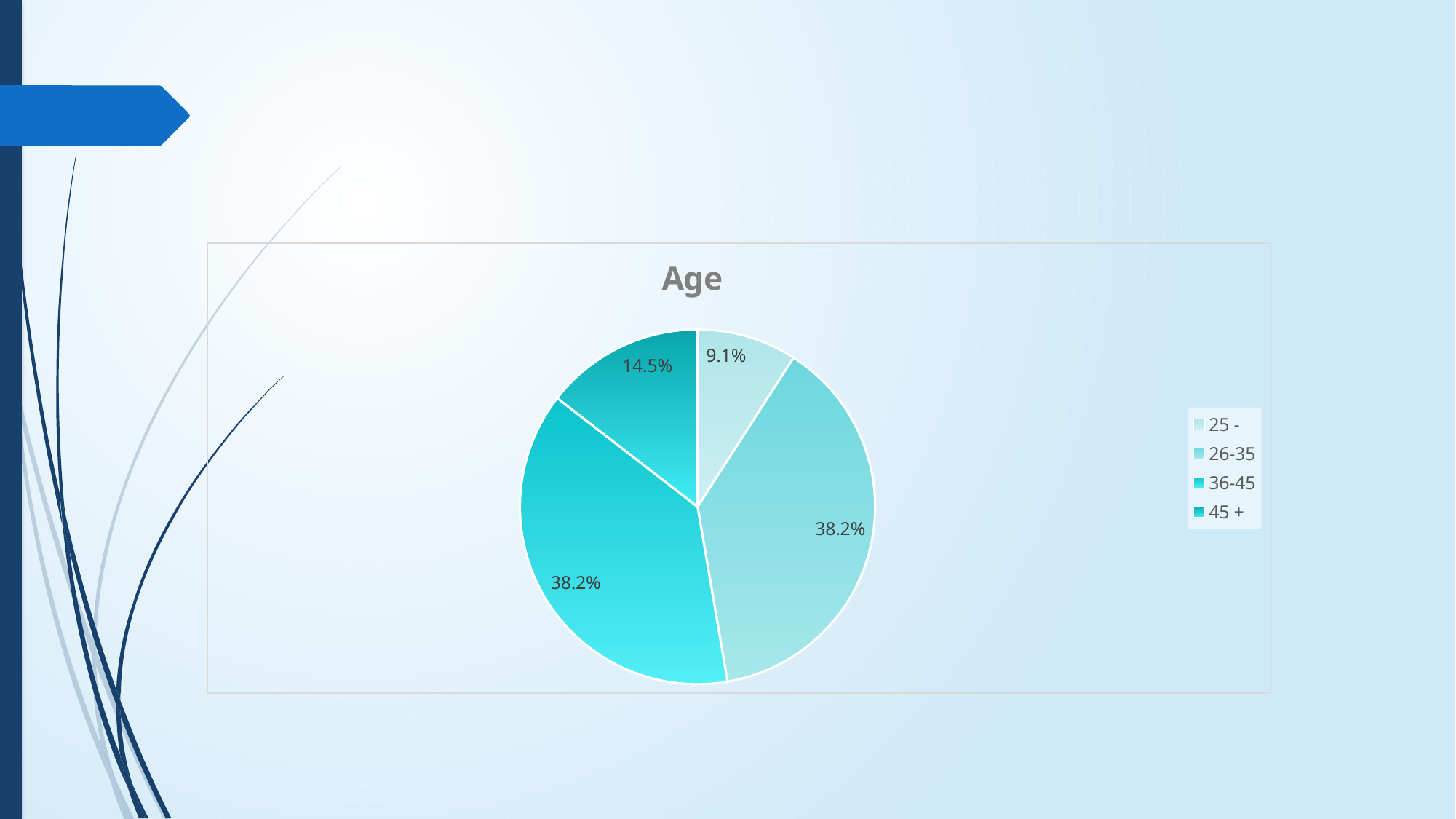
Which slice is larger, 45 + or 25 -? 45 + What share of the pie does the 25 - slice represent? 9.1% What kind of chart is shown on the slide? pie chart What share of the pie does the 36-45 slice represent? 38.2% What share of the pie does the 45 + slice represent? 14.5% How many slices does the pie chart have? 4 What share of the pie does the 26-35 slice represent? 38.2% How many entries does the legend list? 4 Which age group has the smallest slice of the pie? 25 - What is the title of the chart? Age What is the difference between the 45 + share and the 25 - share? 5.4% What is the difference between the 26-35 share and the 45 + share? 23.7%